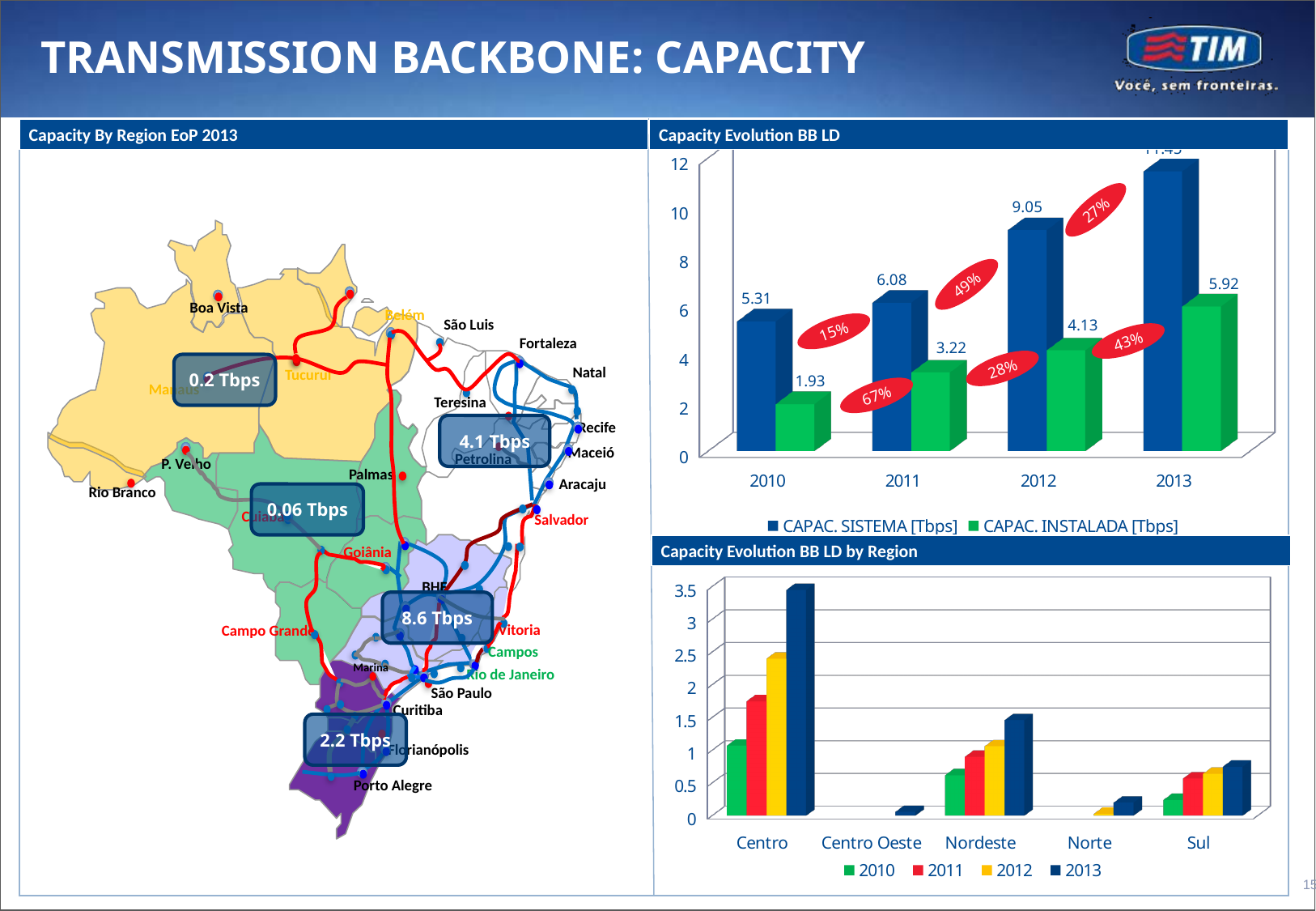
In the Capacity Evolution BB LD chart, what is the difference between CAPAC. SISTEMA and CAPAC. INSTALADA in 2011? 2.86 In the Capacity Evolution BB LD chart, how many years are shown on the x axis? 4 In the Capacity Evolution BB LD chart, do the CAPAC. SISTEMA values rise or fall from 2010 to 2013? rise What kind of chart is the Capacity Evolution BB LD by Region chart? bar chart In the Capacity Evolution BB LD chart, what is the CAPAC. INSTALADA value for 2012? 4.13 In the Capacity Evolution BB LD chart, what is the CAPAC. SISTEMA value for 2010? 5.31 In the Capacity Evolution BB LD chart, how many series does the legend list? 2 In the Capacity Evolution BB LD chart, what is the CAPAC. INSTALADA value for 2013? 5.92 In the Capacity Evolution BB LD by Region chart, is the 2013 value for Centro greater or less than 3? greater In the Capacity Evolution BB LD by Region chart, how many series does the legend list? 4 In the Capacity Evolution BB LD by Region chart, which region has the highest 2013 value? Centro In the Capacity Evolution BB LD chart, is the CAPAC. SISTEMA value for 2013 greater or less than 10? greater